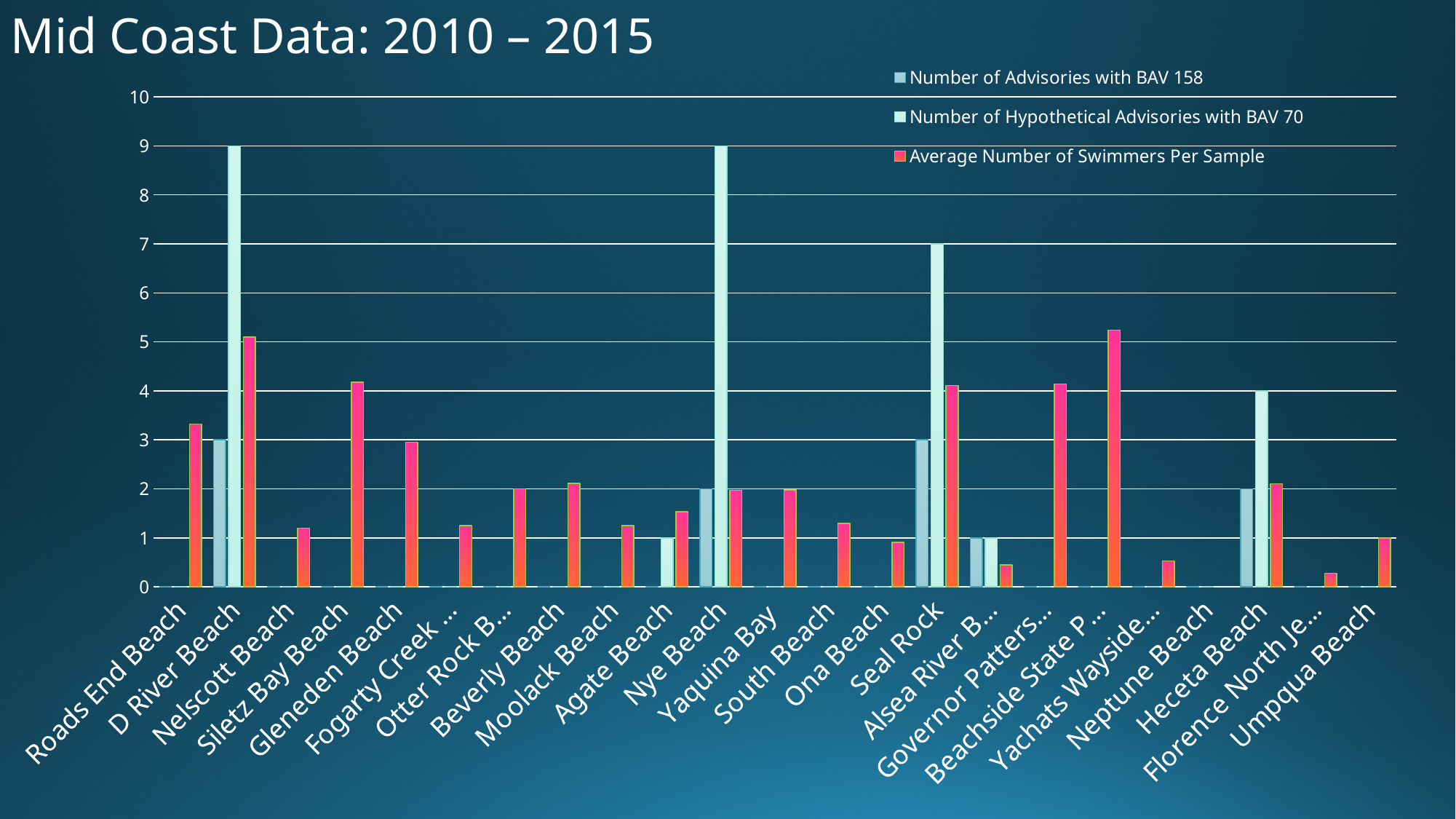
What is the Number of Advisories with BAV 158 for Seal Rock? 3 What kind of chart is shown on the slide? Bar chart What is the Number of Hypothetical Advisories with BAV 70 for Heceta Beach? 4 Which has a higher Number of Hypothetical Advisories with BAV 70, Seal Rock or Heceta Beach? Seal Rock For D River Beach, what is the difference between the Number of Hypothetical Advisories with BAV 70 and the Number of Advisories with BAV 158? 6 How many series does the legend list? 3 How many beaches are shown along the x axis? 23 What is the title of the chart? Mid Coast Data: 2010 – 2015 Is the Average Number of Swimmers Per Sample for Yachats Wayside greater or less than 1? less What is the Number of Hypothetical Advisories with BAV 70 for Seal Rock? 7 What is the Number of Hypothetical Advisories with BAV 70 for D River Beach? 9 Is the Average Number of Swimmers Per Sample for Beachside State P... greater or less than 5? greater